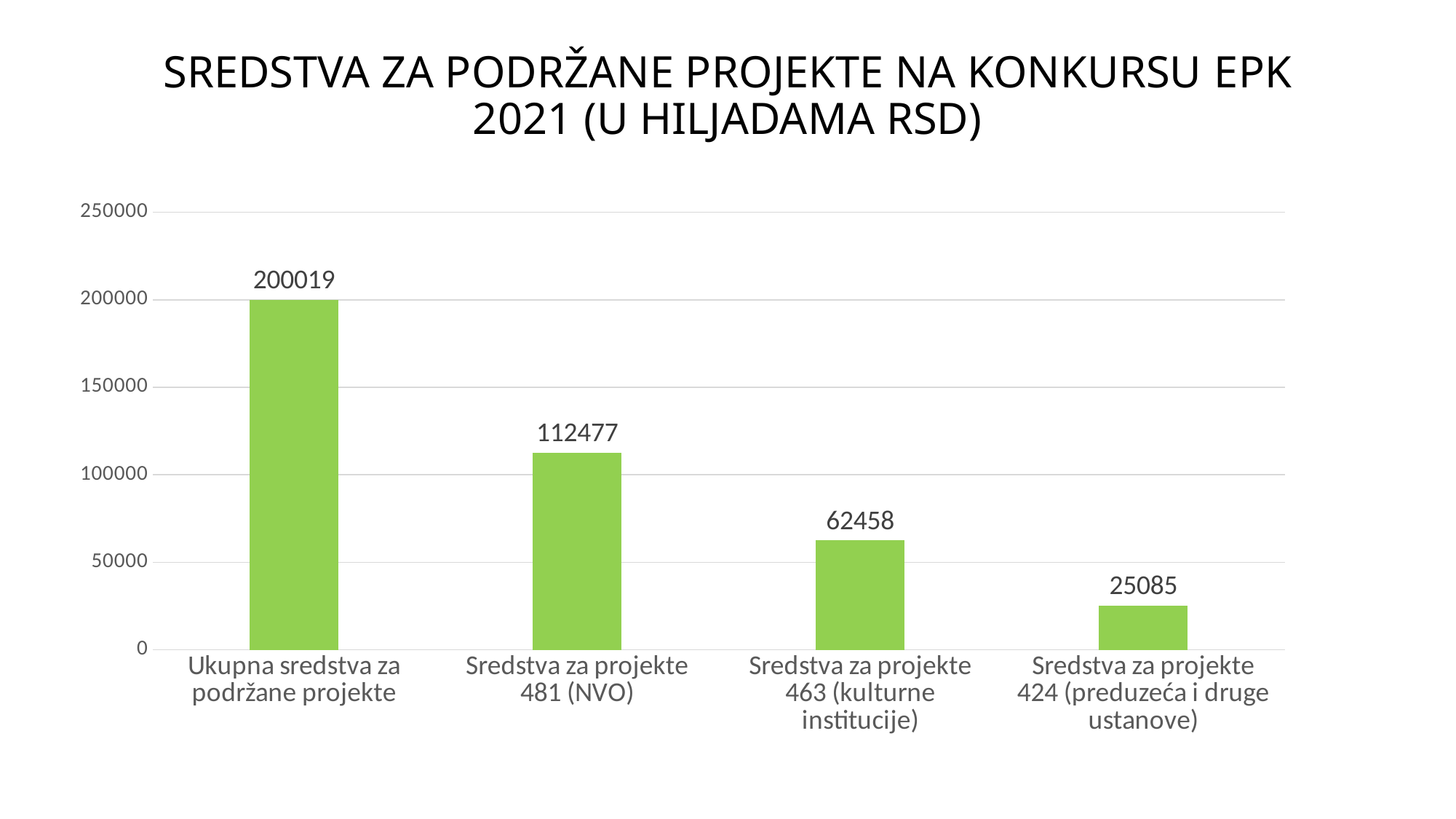
What is the difference between the values for 'Sredstva za projekte 481 (NVO)' and 'Sredstva za projekte 463 (kulturne institucije)'? 50019 Which is larger: the value for 'Sredstva za projekte 463 (kulturne institucije)' or 'Sredstva za projekte 424 (preduzeća i druge ustanove)'? Sredstva za projekte 463 (kulturne institucije) What kind of chart is shown on the slide? bar chart What is the value for 'Sredstva za projekte 424 (preduzeća i druge ustanove)'? 25085 What is the value for 'Sredstva za projekte 463 (kulturne institucije)'? 62458 What is the value for 'Ukupna sredstva za podržane projekte'? 200019 How many categories are shown in the chart? 4 What is the value for 'Sredstva za projekte 481 (NVO)'? 112477 What is the title of the chart? SREDSTVA ZA PODRŽANE PROJEKTE NA KONKURSU EPK 2021 (U HILJADAMA RSD) Is the value for 'Sredstva za projekte 481 (NVO)' greater or less than 100000? greater Which category has the highest value? Ukupna sredstva za podržane projekte Which category has the lowest value? Sredstva za projekte 424 (preduzeća i druge ustanove)